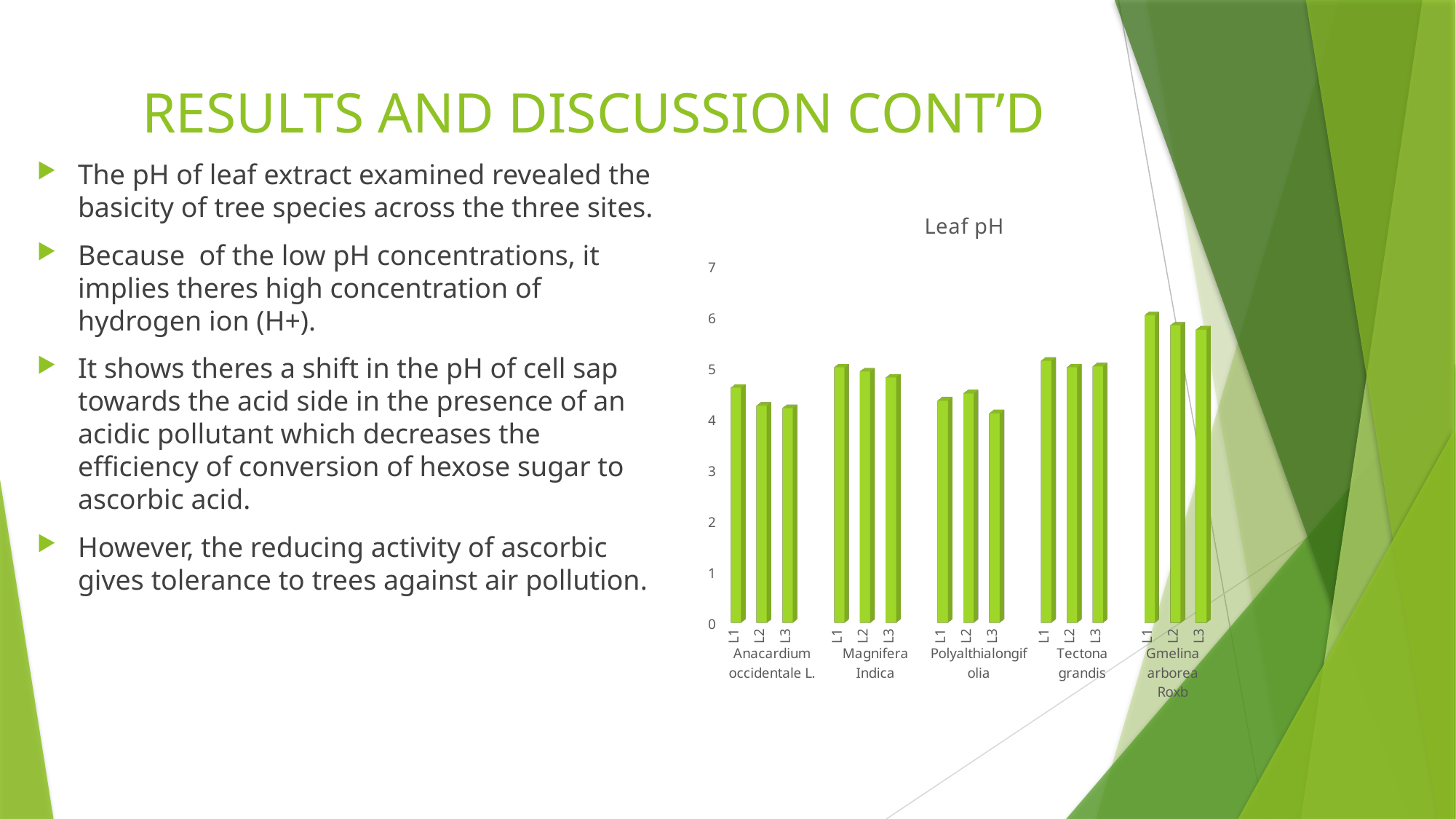
Is the value for Gmelina arborea Roxb L1 greater or less than 5? greater Which bar is the highest in the chart? Gmelina arborea Roxb L1 What is the highest tick value shown on the vertical axis? 7 How many tree species are shown on the x axis of the chart? 5 Is the value for Anacardium occidentale L. L3 greater or less than 5? less Is the value for Polyalthialongifolia L3 greater or less than 5? less Which tree species has the highest leaf pH values overall? Gmelina arborea Roxb What kind of chart is shown on the slide? bar chart What is the title of the chart? Leaf pH Do the values for Gmelina arborea Roxb rise or fall from L1 to L3? fall How many bars are plotted in the chart in total? 15 Which is larger, the value for Gmelina arborea Roxb L1 or the value for Anacardium occidentale L. L1? Gmelina arborea Roxb L1